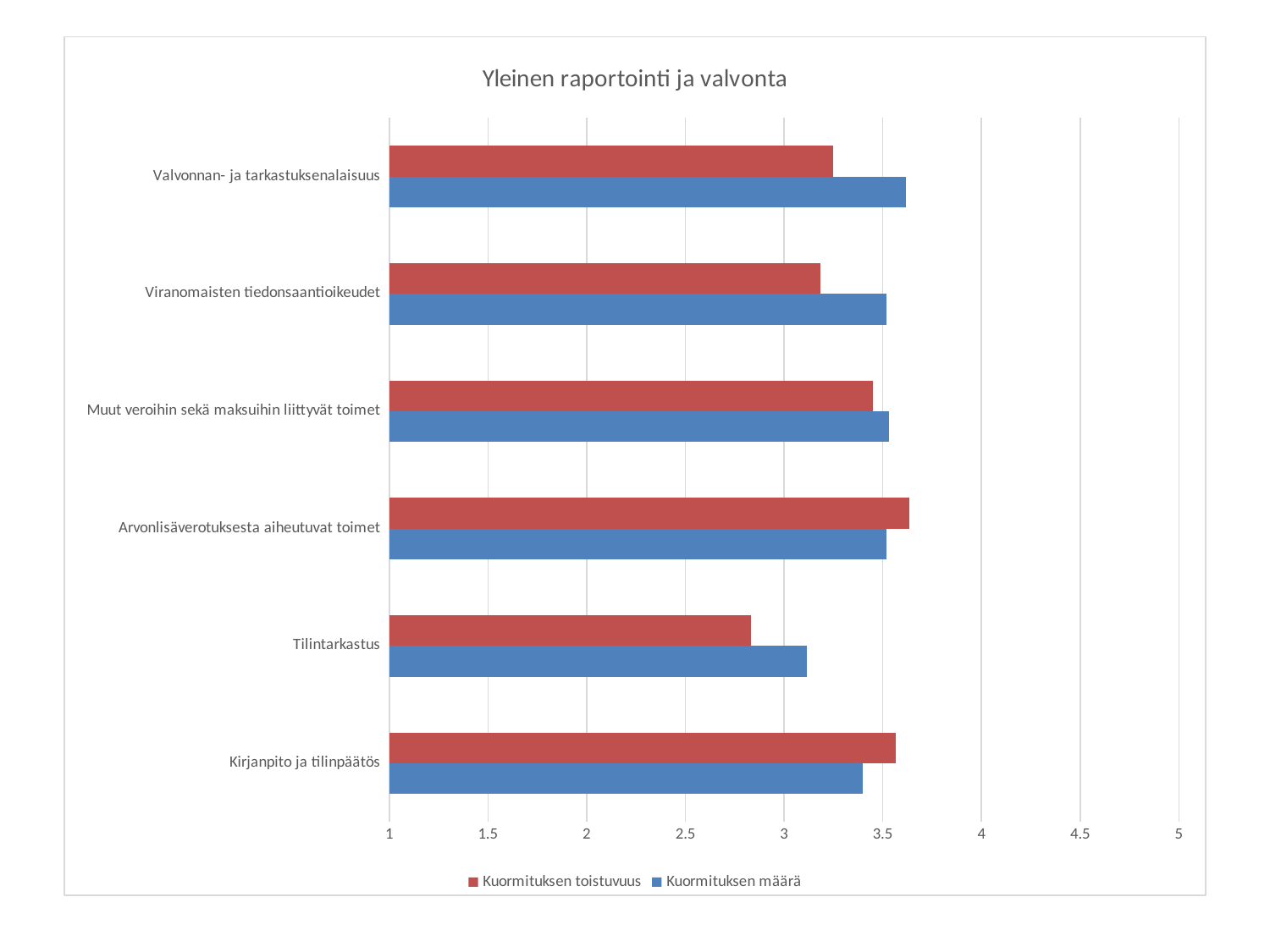
For Kirjanpito ja tilinpäätös, which series has the larger value, Kuormituksen toistuvuus or Kuormituksen määrä? Kuormituksen toistuvuus How many series does the legend list? 2 Is the Kuormituksen määrä value for Kirjanpito ja tilinpäätös greater or less than 3.5? less Which colour represents Kuormituksen määrä in the chart? blue Is the Kuormituksen toistuvuus value for Tilintarkastus greater or less than 3? less Which category has the lowest value for Kuormituksen toistuvuus? Tilintarkastus Is the Kuormituksen määrä value for Valvonnan- ja tarkastuksenalaisuus greater or less than 3.5? greater What is the title of the chart? Yleinen raportointi ja valvonta How many categories are shown on the chart? 6 For Valvonnan- ja tarkastuksenalaisuus, which series has the larger value, Kuormituksen toistuvuus or Kuormituksen määrä? Kuormituksen määrä What kind of chart is shown on the slide? bar chart Which category has the lowest value for Kuormituksen määrä? Tilintarkastus